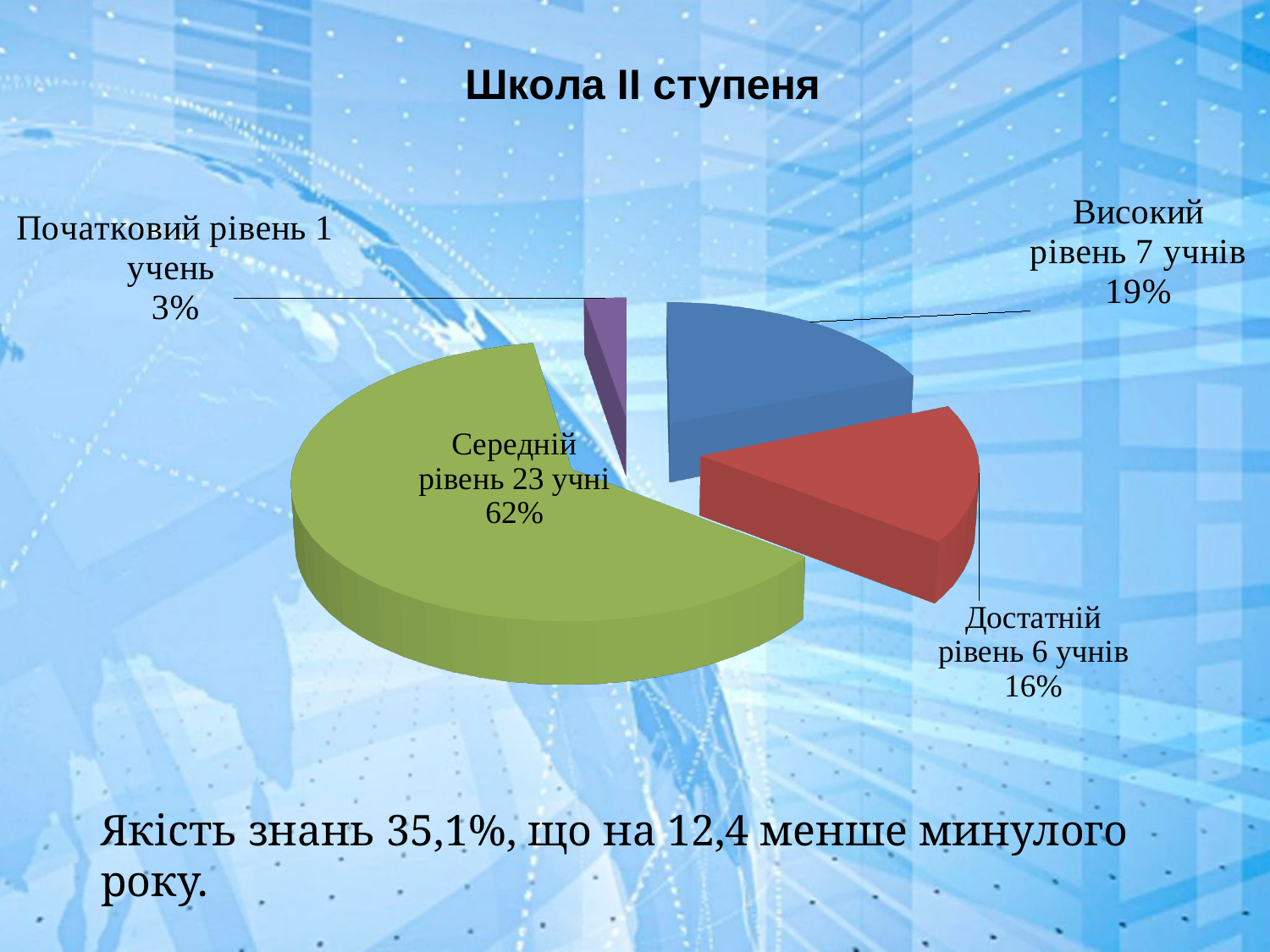
How many students are at Високий рівень? 7 What share of the pie does Високий рівень have? 19% What share of the pie does Достатній рівень have? 16% Which level has the largest slice of the pie? Середній рівень What kind of chart is shown on the slide? pie chart What is the difference in the number of students between Високий рівень and Достатній рівень? 1 How many students are at Середній рівень? 23 What is the title of the chart? Школа ІІ ступеня How many slices does the pie chart have? 4 Which level has the smallest slice of the pie? Початковий рівень What share of the pie does Початковий рівень have? 3%